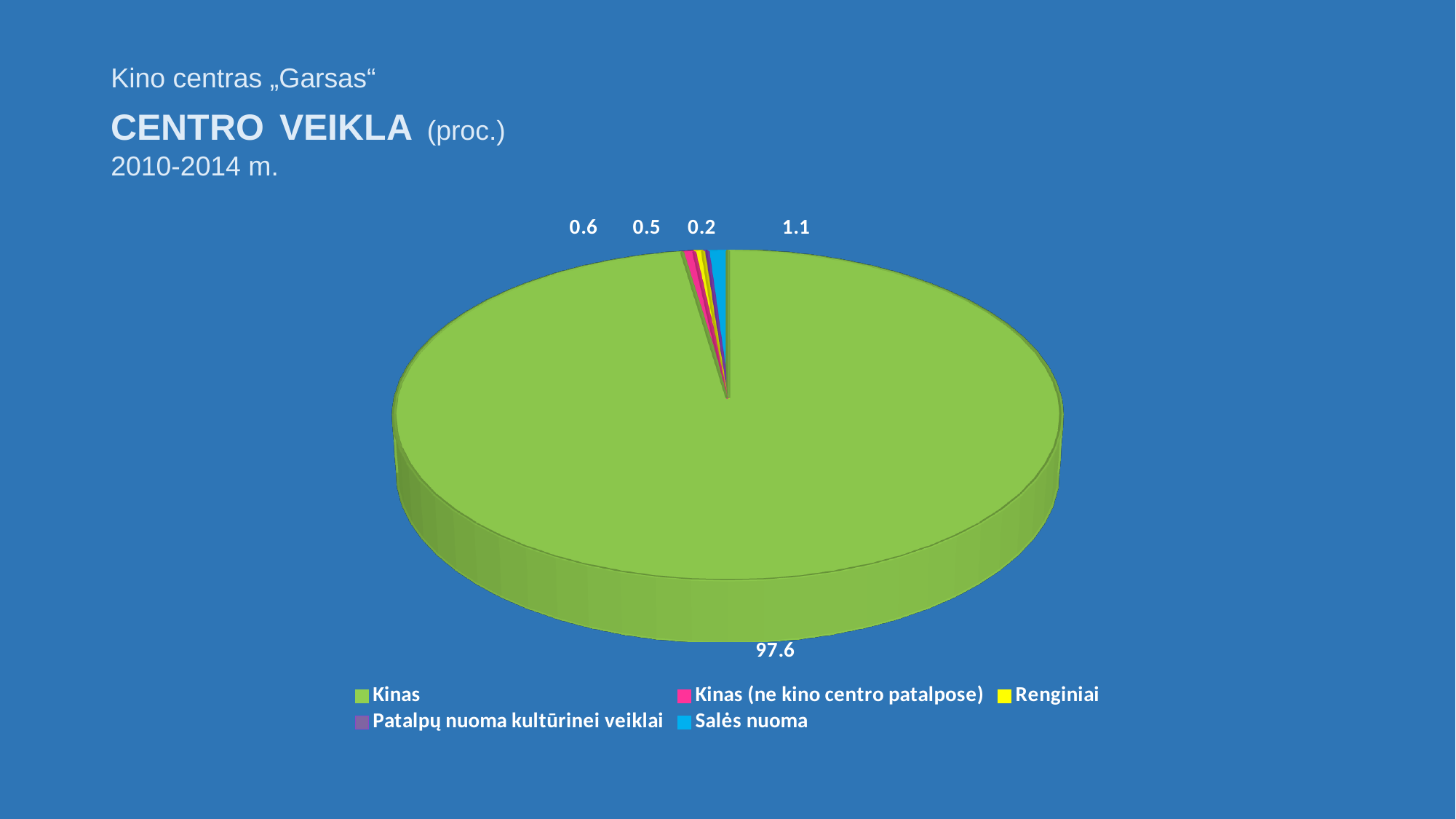
What kind of chart is shown on the slide? pie chart Which category has the largest slice? Kinas Which category has the smallest slice? Patalpų nuoma kultūrinei veiklai What is the value for Salės nuoma? 1.1 Which is larger, the value for Salės nuoma or the value for Kinas (ne kino centro patalpose)? Salės nuoma What is the value for Kinas? 97.6 What colour is the Kinas slice? green What is the value for Renginiai? 0.5 What is the value for Patalpų nuoma kultūrinei veiklai? 0.2 How many categories does the legend list? 5 What is the value for Kinas (ne kino centro patalpose)? 0.6 What is the difference between the values for Salės nuoma and Renginiai? 0.6